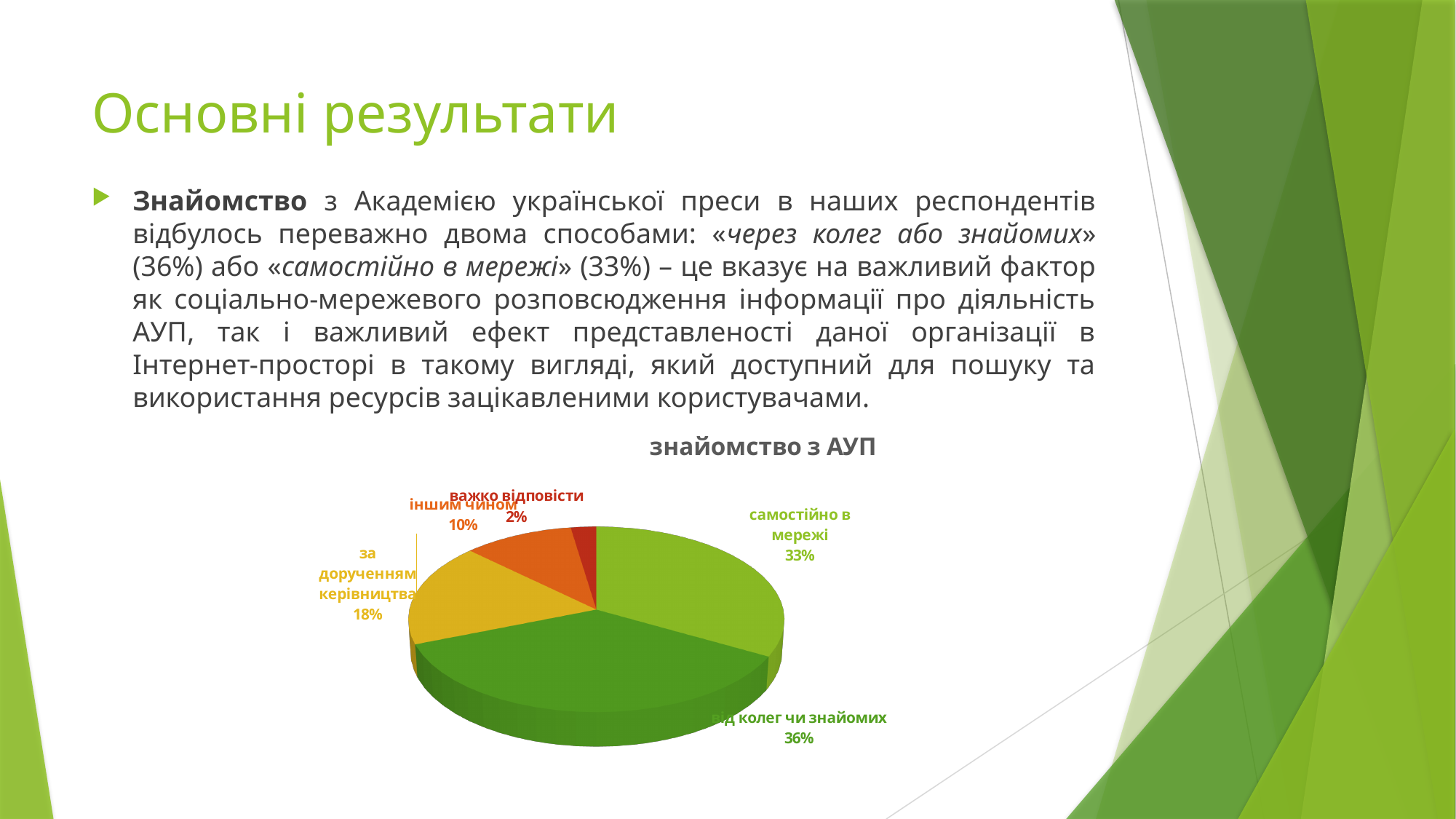
What share of the pie is labelled "від колег чи знайомих"? 36% What is the title of the chart? знайомство з АУП Which category has the smallest slice of the pie? важко відповісти What is the difference in percentage points between "від колег чи знайомих" and "за дорученням керівництва"? 18 What kind of chart is shown on the slide? pie chart Which is larger: the slice for "за дорученням керівництва" or the slice for "іншим чином"? за дорученням керівництва How many slices does the pie chart have? 5 Which category has the largest slice of the pie? від колег чи знайомих What share of the pie is labelled "за дорученням керівництва"? 18% What share of the pie is labelled "самостійно в мережі"? 33% What share of the pie is labelled "іншим чином"? 10% What share of the pie is labelled "важко відповісти"? 2%